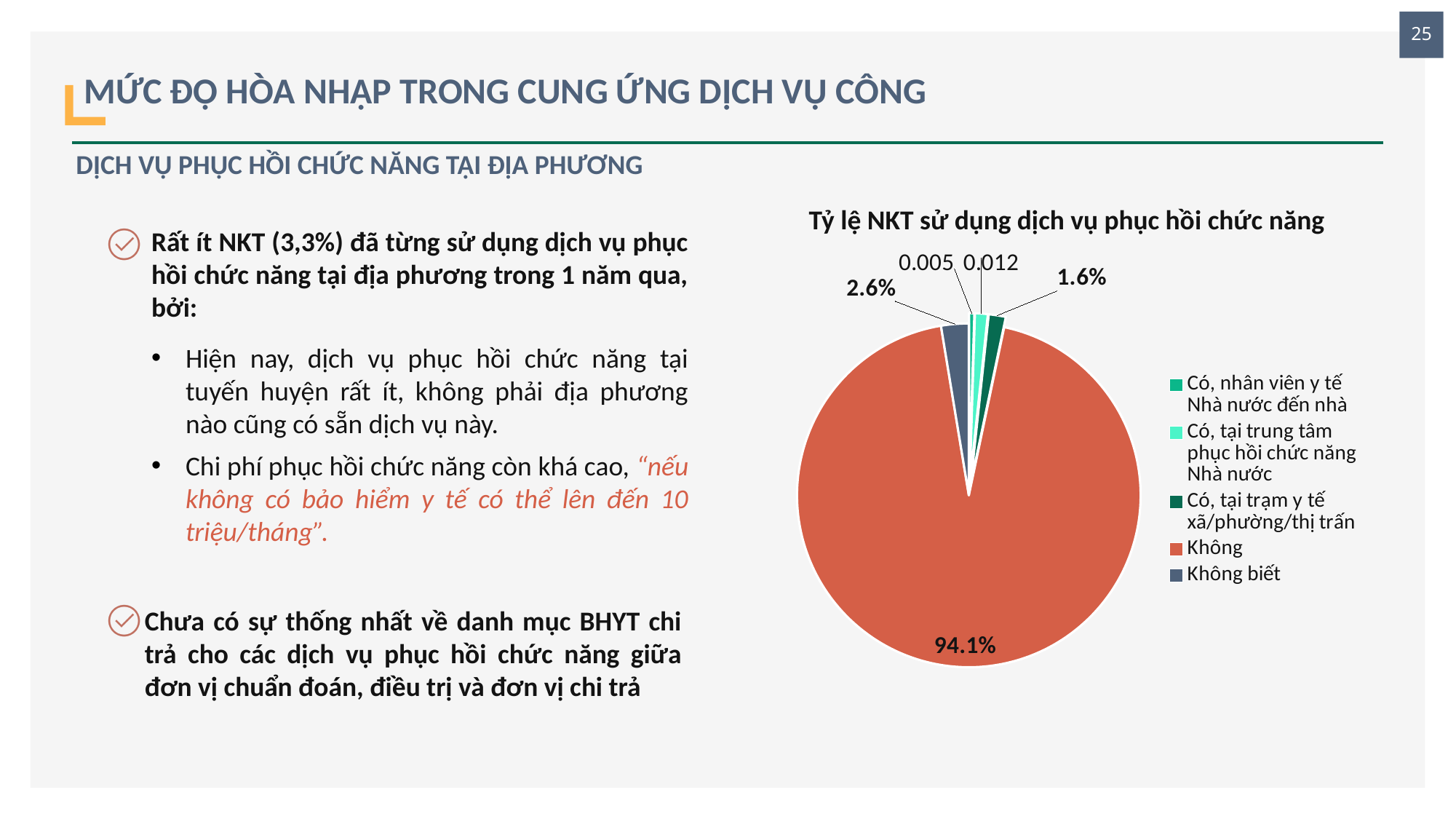
In the pie chart, what is the value shown for "Có, tại trạm y tế xã/phường/thị trấn"? 1.6% What is the title of the pie chart? Tỷ lệ NKT sử dụng dịch vụ phục hồi chức năng In the pie chart, what is the value shown for "Có, tại trung tâm phục hồi chức năng Nhà nước"? 0.012 In the pie chart, what is the value shown for "Không"? 94.1% Which category has the largest slice in the pie chart? Không What type of chart is shown on the slide? Pie chart Which category has the smallest slice in the pie chart? Có, nhân viên y tế Nhà nước đến nhà In the pie chart, what is the value shown for "Không biết"? 2.6% How many categories does the legend of the pie chart list? 5 In the pie chart, what is the value shown for "Có, nhân viên y tế Nhà nước đến nhà"? 0.005 In the pie chart, which is larger: "Không biết" or "Có, tại trạm y tế xã/phường/thị trấn"? Không biết In the pie chart, what is the difference between the values for "Không" and "Không biết"? 91.5 percentage points